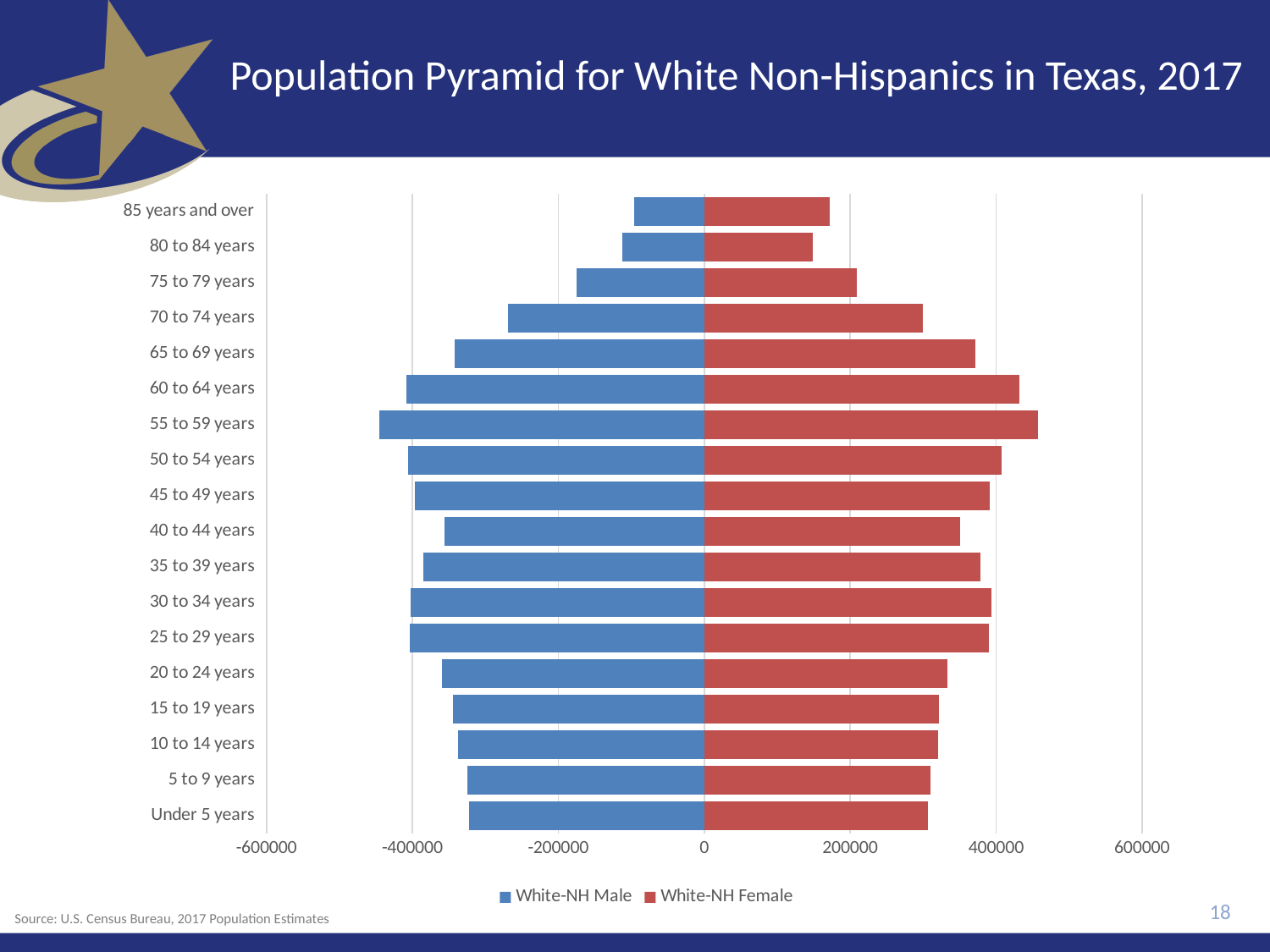
Is the White-NH Female value for 80 to 84 years greater or less than 200000? less What is the title of the chart on the slide? Population Pyramid for White Non-Hispanics in Texas, 2017 What kind of chart is shown on the slide? Bar chart How many age groups are listed on the vertical axis of the chart? 18 Which is larger, the White-NH Female value for 65 to 69 years or for 70 to 74 years? 65 to 69 years Is the White-NH Female value for 40 to 44 years greater or less than 400000? less How many series does the chart legend list? 2 Which age group has the shortest White-NH Male bar? 85 years and over Which age group has the longest White-NH Male bar? 55 to 59 years Which age group has the shortest White-NH Female bar? 80 to 84 years Which age group has the longest White-NH Female bar? 55 to 59 years Is the White-NH Female value for 55 to 59 years greater or less than 400000? greater